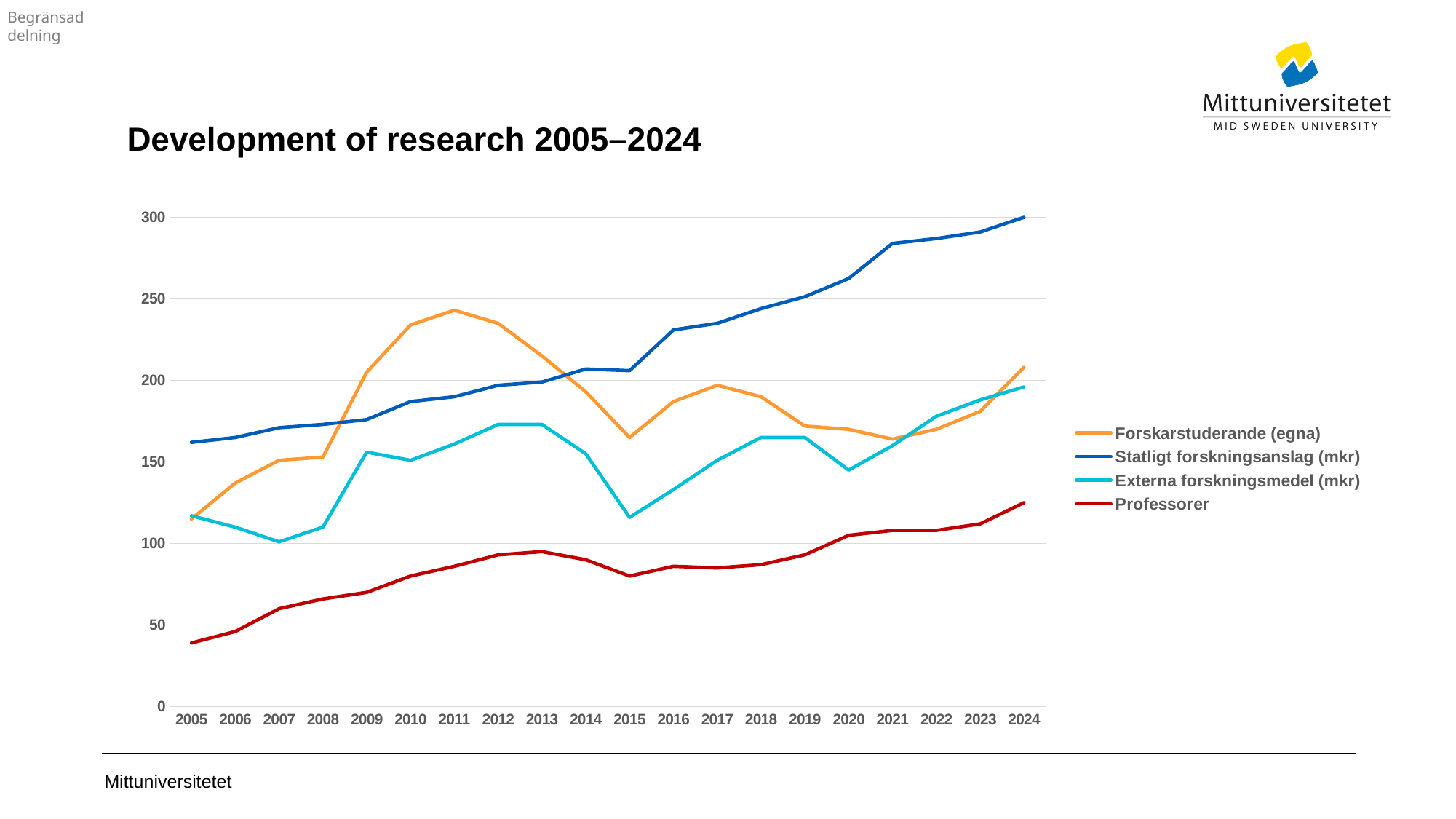
In which year does the Forskarstuderande (egna) series reach its highest value? 2011 Does the Statligt forskningsanslag (mkr) series generally rise or fall from 2005 to 2024? rise Is the value for Professorer in 2005 greater or less than 50? less Is the value for Forskarstuderande (egna) in 2011 greater or less than 200? greater Is the value for Statligt forskningsanslag (mkr) in 2021 greater or less than 250? greater In 2010, which is larger: Forskarstuderande (egna) or Externa forskningsmedel (mkr)? Forskarstuderande (egna) How many series does the legend list? 4 What kind of chart is shown on the slide? line chart How many years are shown along the x axis? 20 Which series has the lowest value in 2024? Professorer What is the title of the chart? Development of research 2005–2024 Which series has the highest value in 2024? Statligt forskningsanslag (mkr)